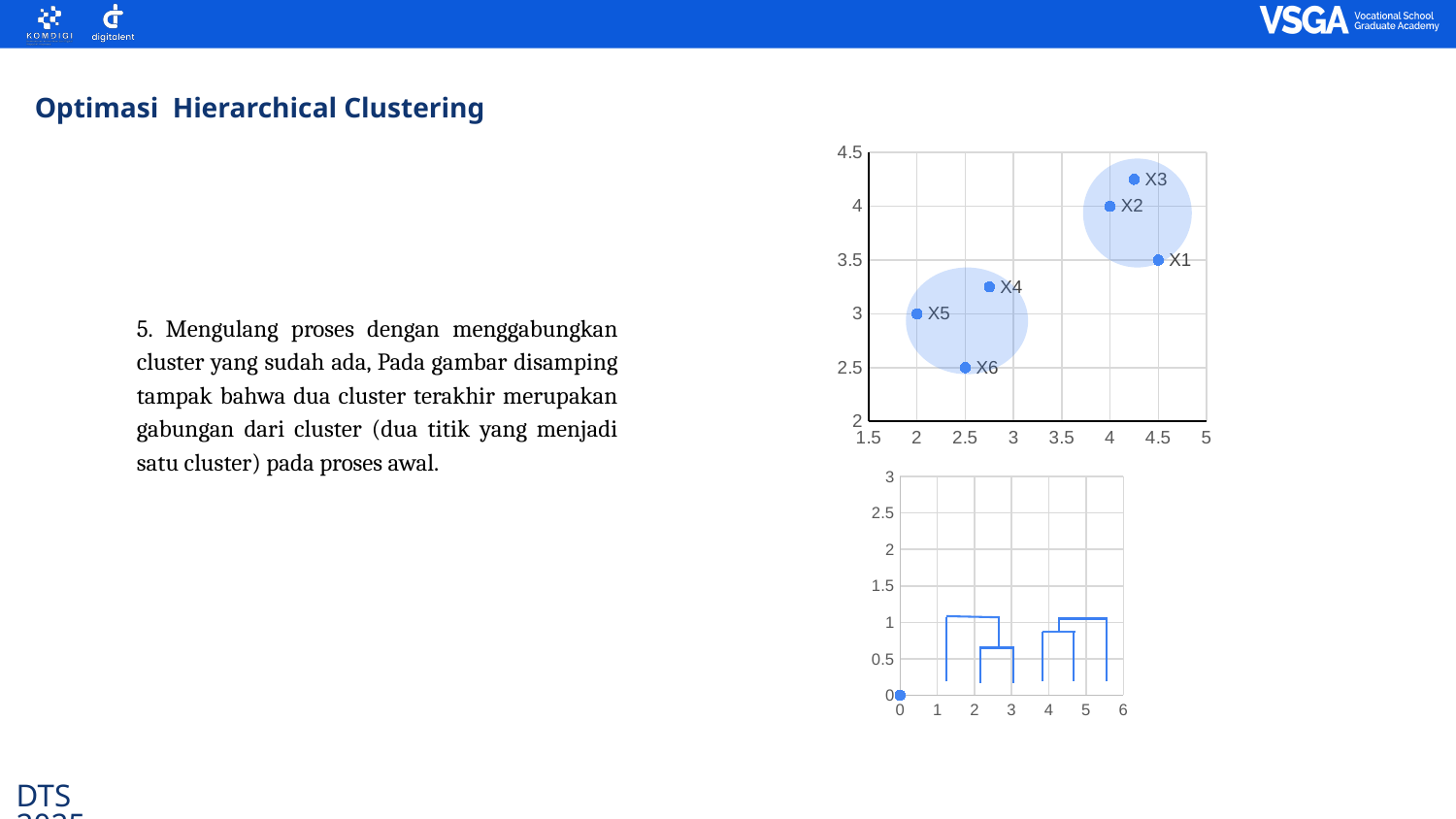
In the top scatter chart, how many shaded cluster circles are drawn around the points? 2 In the top scatter chart, which point has the highest y-value? X3 In the top scatter chart, what is the y-value of X6? 2.5 In the top scatter chart, which point has a higher y-value, X5 or X2? X2 In the top scatter chart, is the y-value of X4 greater or less than 3? greater In the top scatter chart, what is the x-value of X2? 4 In the top scatter chart, how many labeled data points are plotted? 6 In the top scatter chart, what is the y-value of X1? 3.5 In the top scatter chart, which point has the largest x-value? X1 What kind of chart is the top chart on the slide? scatter chart In the top scatter chart, which point has the lowest y-value? X6 In the top scatter chart, which point has the smallest x-value? X5